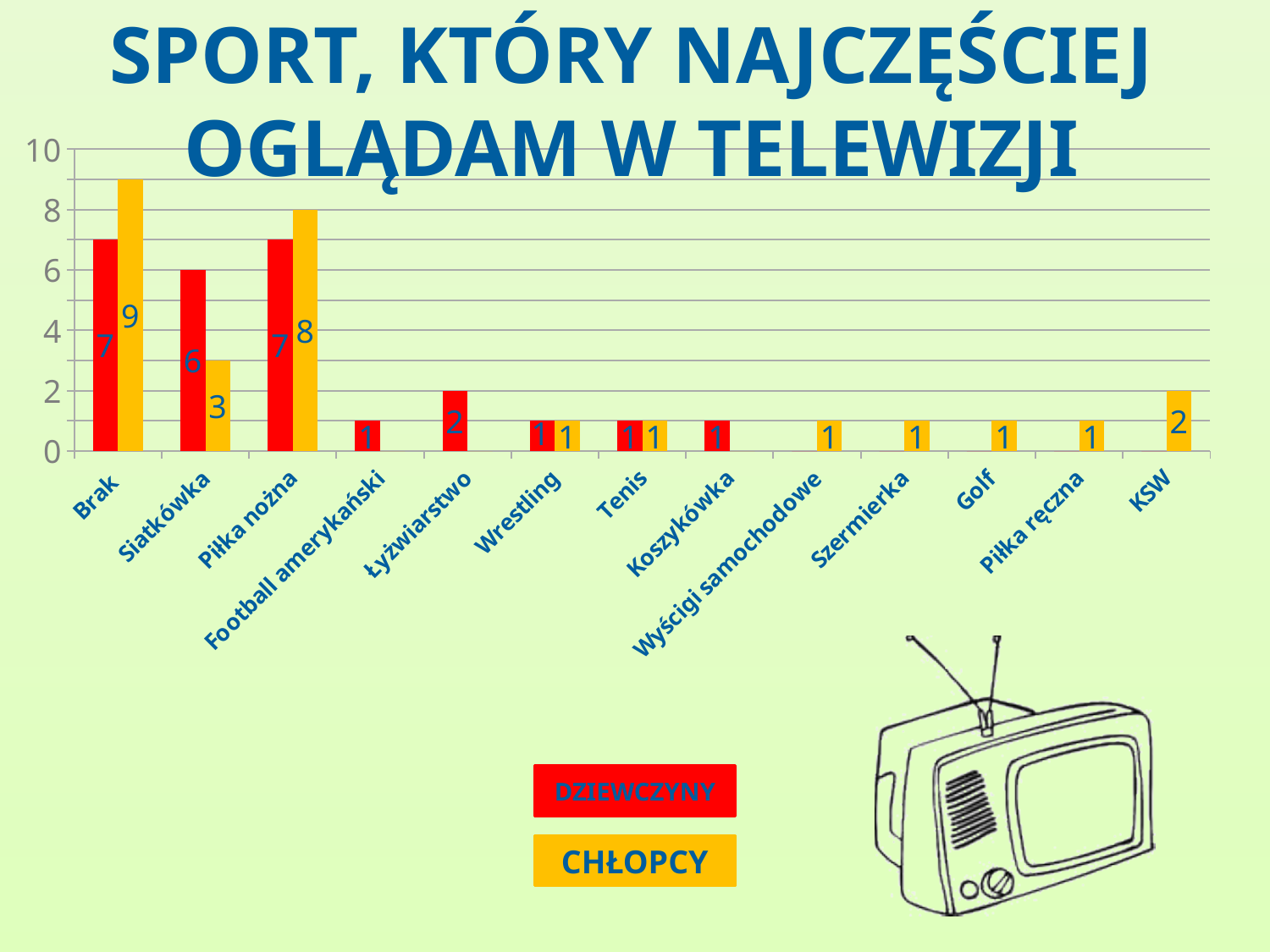
Is the CHŁOPCY value for Brak greater or less than 8? greater Which colour represents DZIEWCZYNY in the chart? red What is the value for CHŁOPCY in the Piłka nożna category? 8 What is the value for DZIEWCZYNY in the Siatkówka category? 6 Which category has the highest value for CHŁOPCY? Brak What is the value for CHŁOPCY in the KSW category? 2 What kind of chart is shown on the slide? bar chart Which is larger for Piłka nożna: the DZIEWCZYNY value or the CHŁOPCY value? CHŁOPCY How many series does the legend list? 2 What is the difference between the DZIEWCZYNY and CHŁOPCY values for Siatkówka? 3 How many categories are shown on the x axis? 13 What is the value for CHŁOPCY in the Brak category? 9